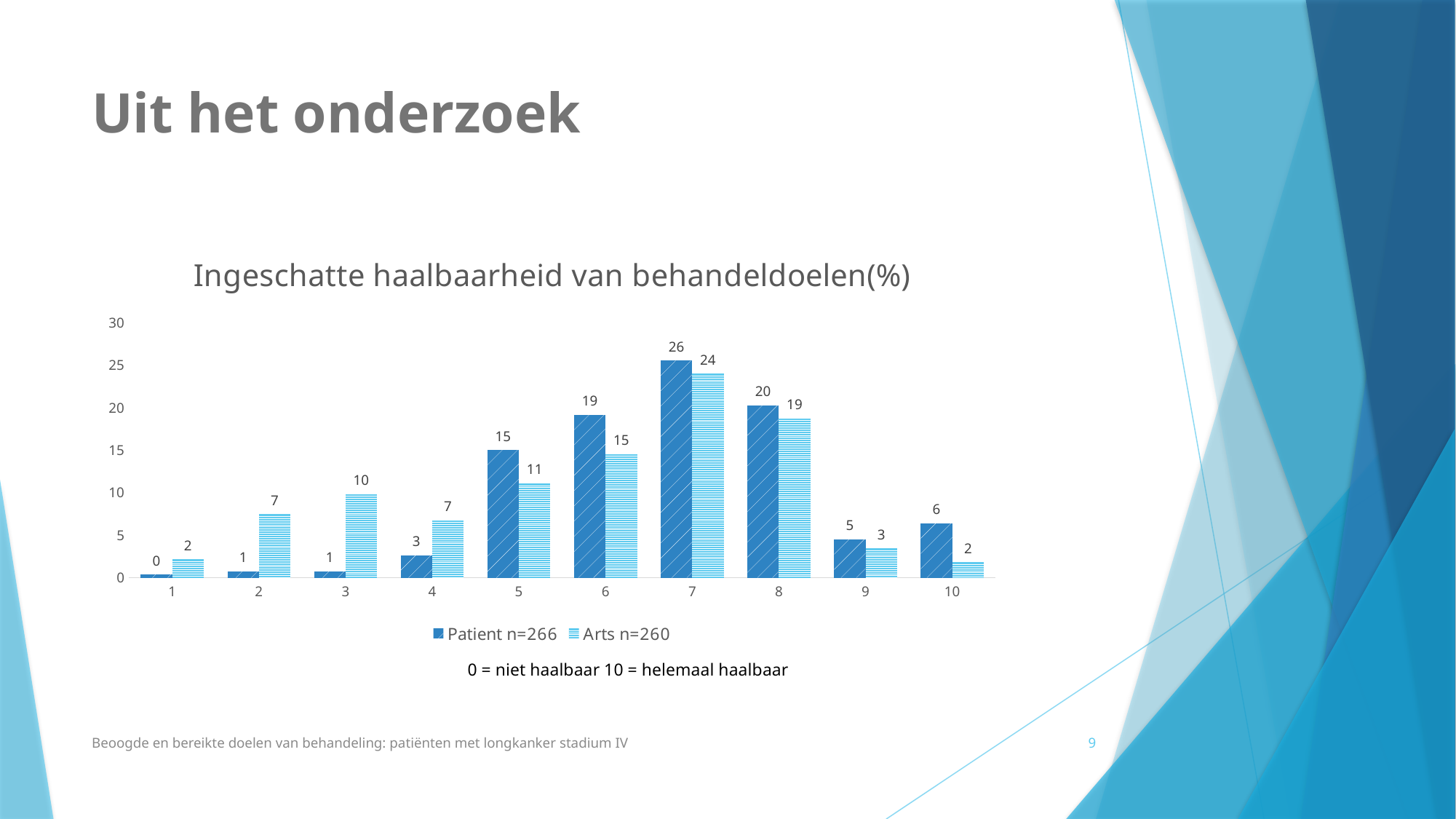
Is the value for Patient n=266 at category 8 greater or less than 15? greater What is the title of the chart? Ingeschatte haalbaarheid van behandeldoelen(%) Which category has the highest value for Patient n=266? 7 What is the value for Arts n=260 at category 3? 10 Which category has the lowest value for Patient n=266? 1 How many categories are shown on the x axis? 10 How many series does the legend list? 2 What kind of chart is shown on the slide? bar chart What is the value for Arts n=260 at category 6? 15 What is the value for Patient n=266 at category 7? 26 Which is larger at category 2: Patient n=266 or Arts n=260? Arts n=260 What is the difference between Patient n=266 and Arts n=260 at category 5? 4